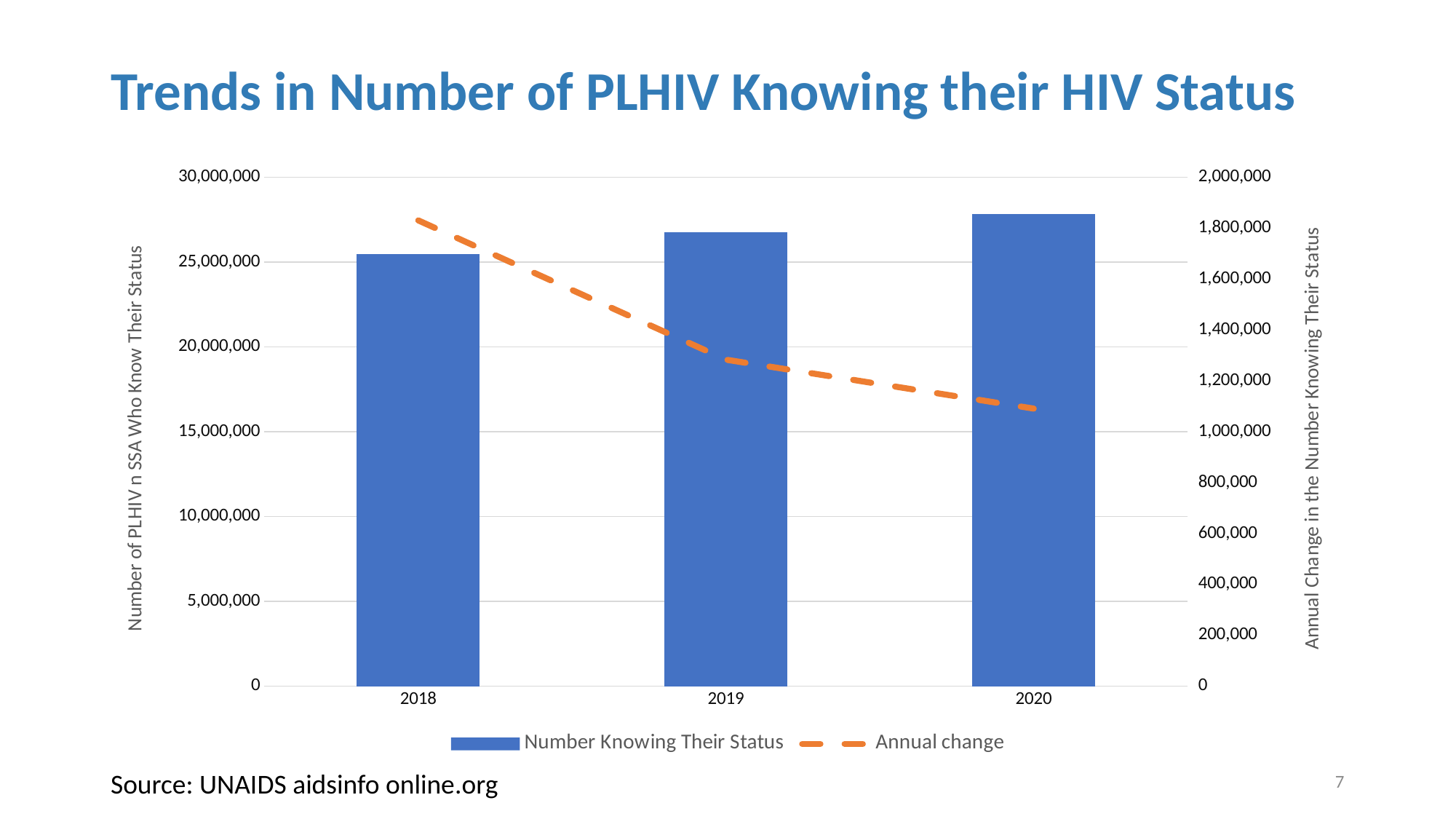
How many years are shown on the x axis of the chart? 3 Which is larger, the Number Knowing Their Status bar for 2019 or for 2018? 2019 Is the Annual change value for 2019 greater or less than 1,400,000? less Which year has the lowest bar for Number Knowing Their Status? 2018 Which year has the highest bar for Number Knowing Their Status? 2020 Does the Annual change line rise or fall from 2018 to 2020? Falls Is the Number Knowing Their Status bar for 2018 greater or less than 25,000,000? greater Is the Annual change value for 2018 greater or less than 1,600,000? greater What is the title of the chart on the slide? Trends in Number of PLHIV Knowing their HIV Status How many series does the chart's legend list? 2 What type of chart is shown on the slide? A combination bar and line chart